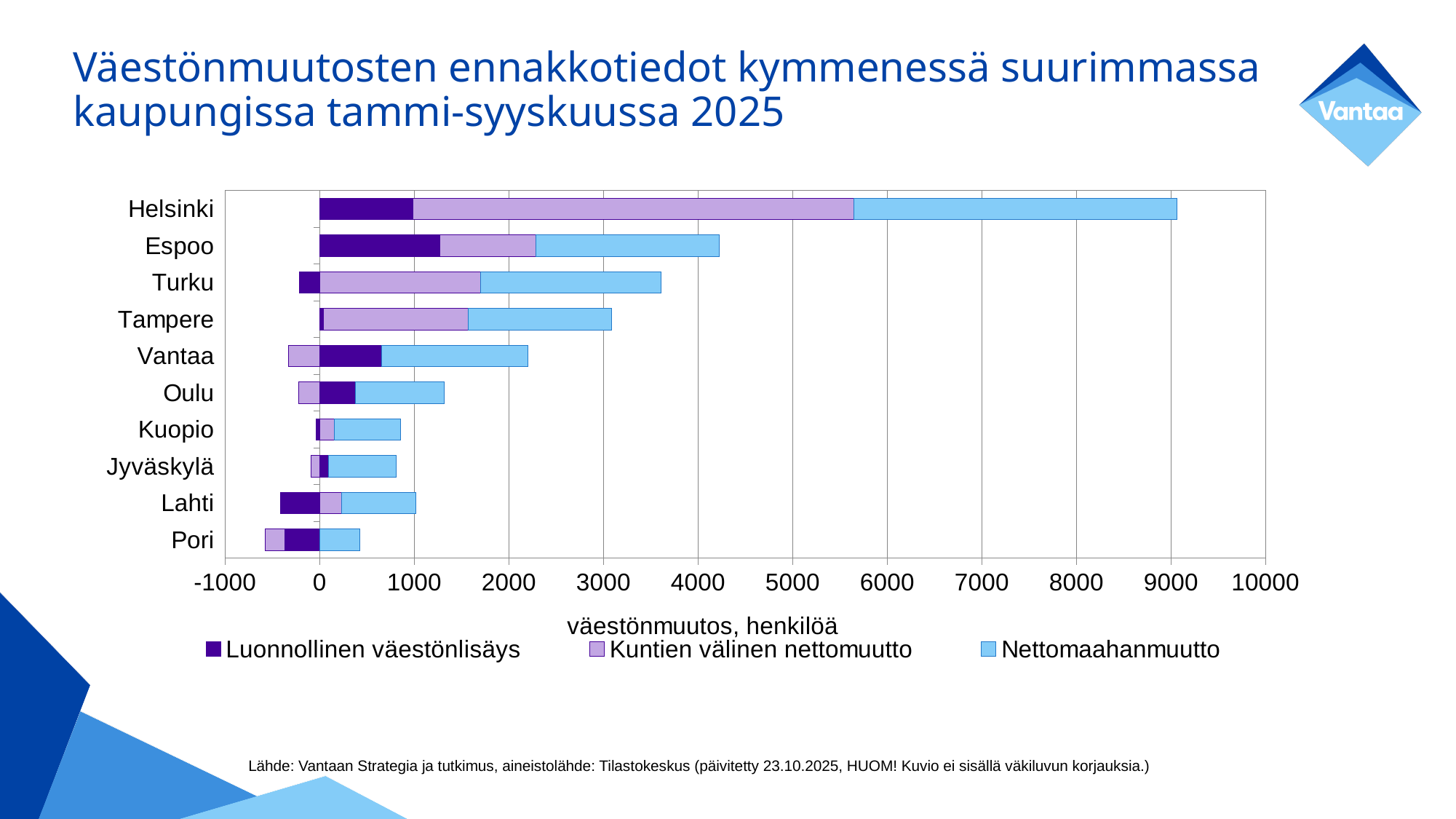
Which city has the larger Nettomaahanmuutto segment, Helsinki or Espoo? Helsinki Which city has the longest total bar on the chart? Helsinki Is the total bar for Kuopio greater or less than 1000? less What kind of chart is shown on the slide? Stacked horizontal bar chart Is the Luonnollinen väestönlisäys value for Espoo greater or less than 1000? greater What is the title of the horizontal axis? väestönmuutos, henkilöä How many cities are shown on the chart? 10 Which city has the largest Luonnollinen väestönlisäys value? Espoo How many series does the legend list? 3 Is the total bar for Espoo greater or less than 4000? greater Which city has the larger total bar, Turku or Vantaa? Turku Which city has the largest Kuntien välinen nettomuutto segment? Helsinki